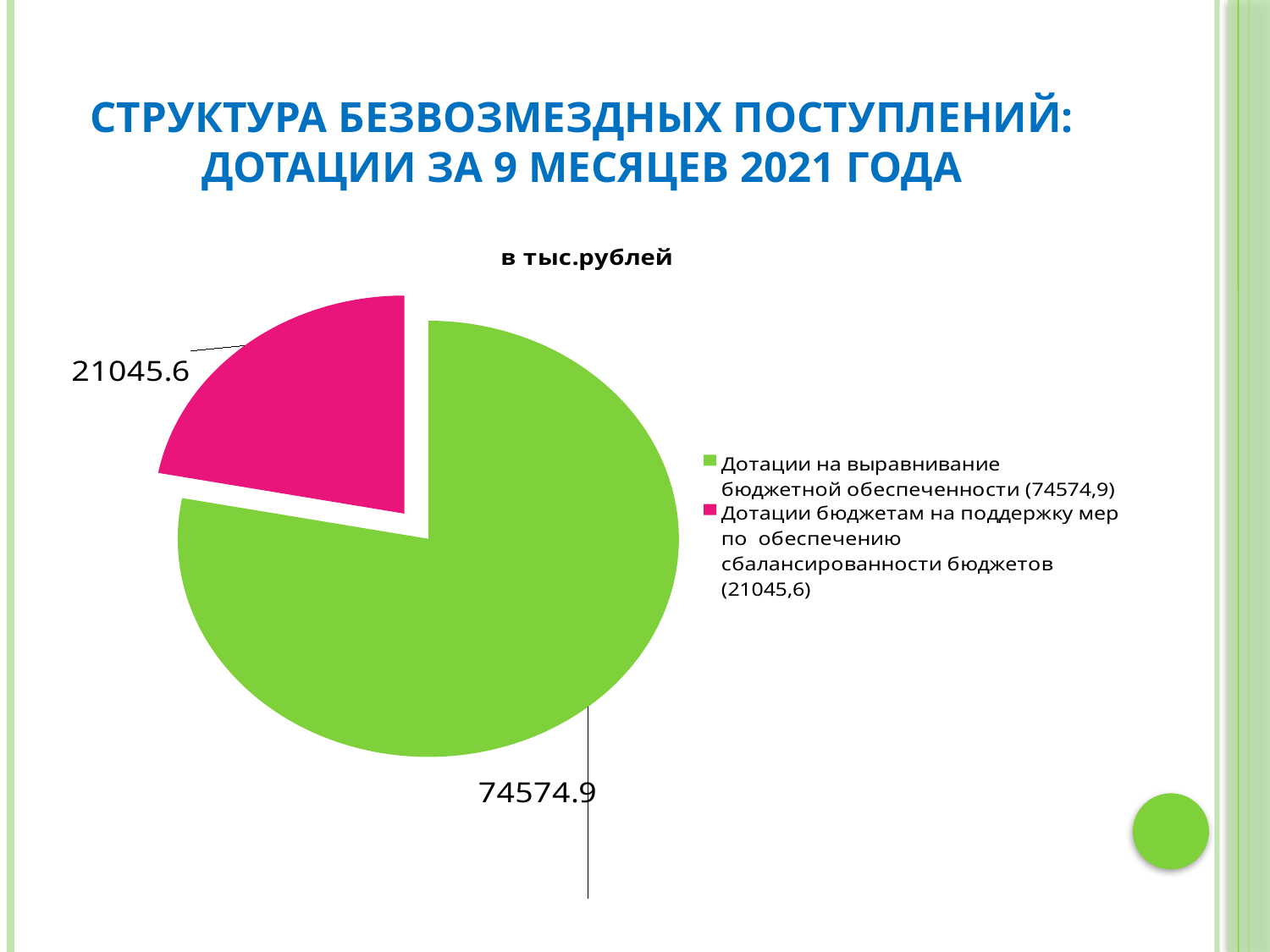
Which is larger: the value for Дотации на выравнивание бюджетной обеспеченности or the value for Дотации бюджетам на поддержку мер по обеспечению сбалансированности бюджетов? Дотации на выравнивание бюджетной обеспеченности How many slices does the pie chart have? 2 What is the difference between the value for Дотации на выравнивание бюджетной обеспеченности and the value for Дотации бюджетам на поддержку мер по обеспечению сбалансированности бюджетов? 53529.3 What is the total of the two slices in the pie chart? 95620.5 How many entries does the legend list? 2 What is the value for Дотации на выравнивание бюджетной обеспеченности? 74574.9 Which category has the smallest slice of the pie? Дотации бюджетам на поддержку мер по обеспечению сбалансированности бюджетов What is the value for Дотации бюджетам на поддержку мер по обеспечению сбалансированности бюджетов? 21045.6 What unit is stated in the chart title above the pie? в тыс.рублей What share of the pie does the slice for Дотации на выравнивание бюджетной обеспеченности represent, to the nearest whole percent? 78% Which category has the largest slice of the pie? Дотации на выравнивание бюджетной обеспеченности What kind of chart is shown on the slide? Pie chart